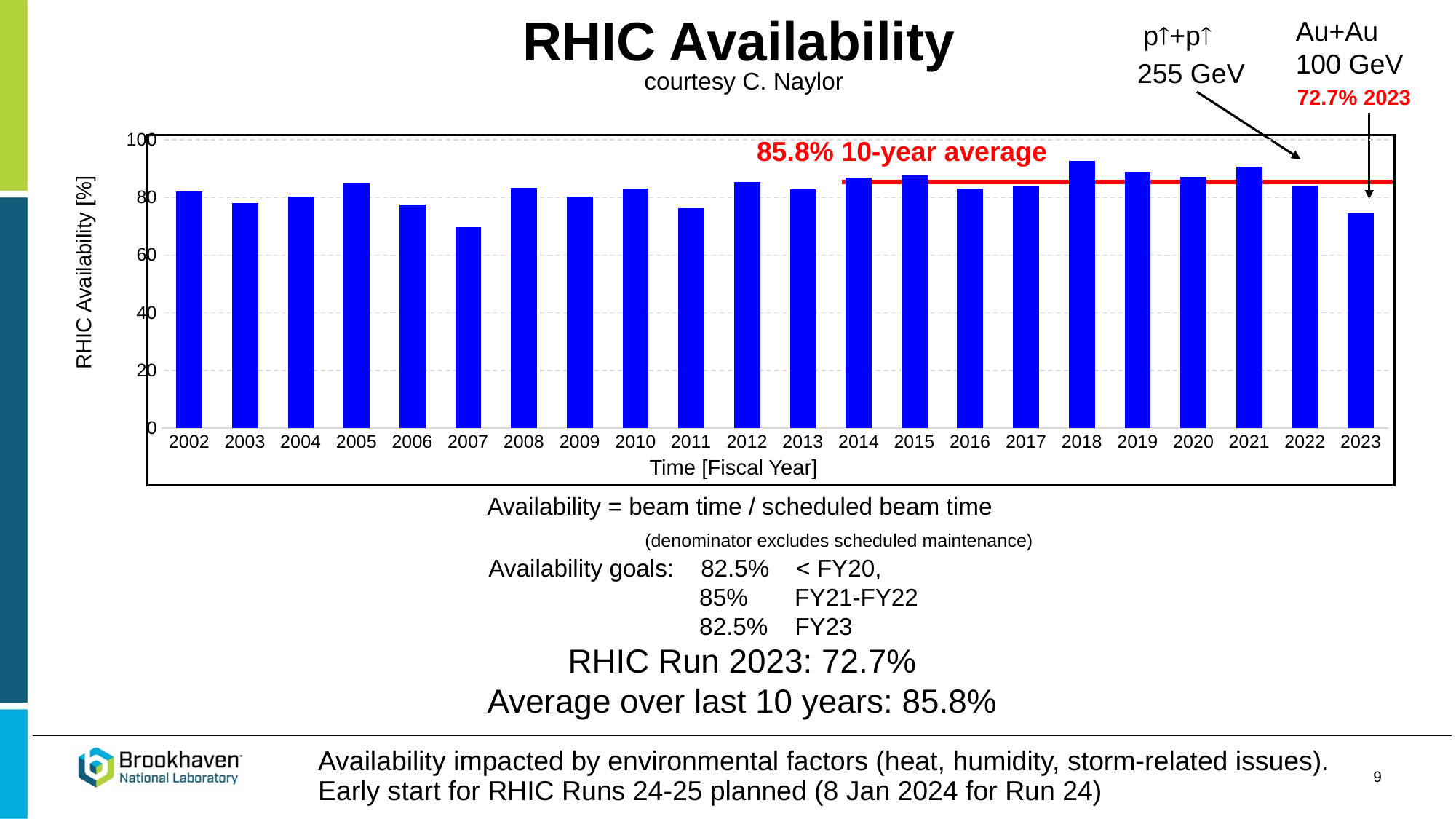
What is the label of the x axis of the chart? Time [Fiscal Year] Which fiscal year has the highest RHIC availability? 2018 Which year has the larger RHIC availability, 2005 or 2006? 2005 Is the RHIC availability for 2005 greater or less than 80? greater What is the RHIC availability value annotated for 2023? 72.7% How many fiscal years are plotted in the RHIC Availability chart? 22 What value does the red horizontal line in the chart represent? 85.8% 10-year average Is the RHIC availability for 2007 greater or less than 80? less Is the RHIC availability for 2011 greater or less than 80? less What kind of chart is shown on the slide? bar chart Which fiscal year has the lowest RHIC availability? 2007 Which year has the larger RHIC availability, 2018 or 2023? 2018